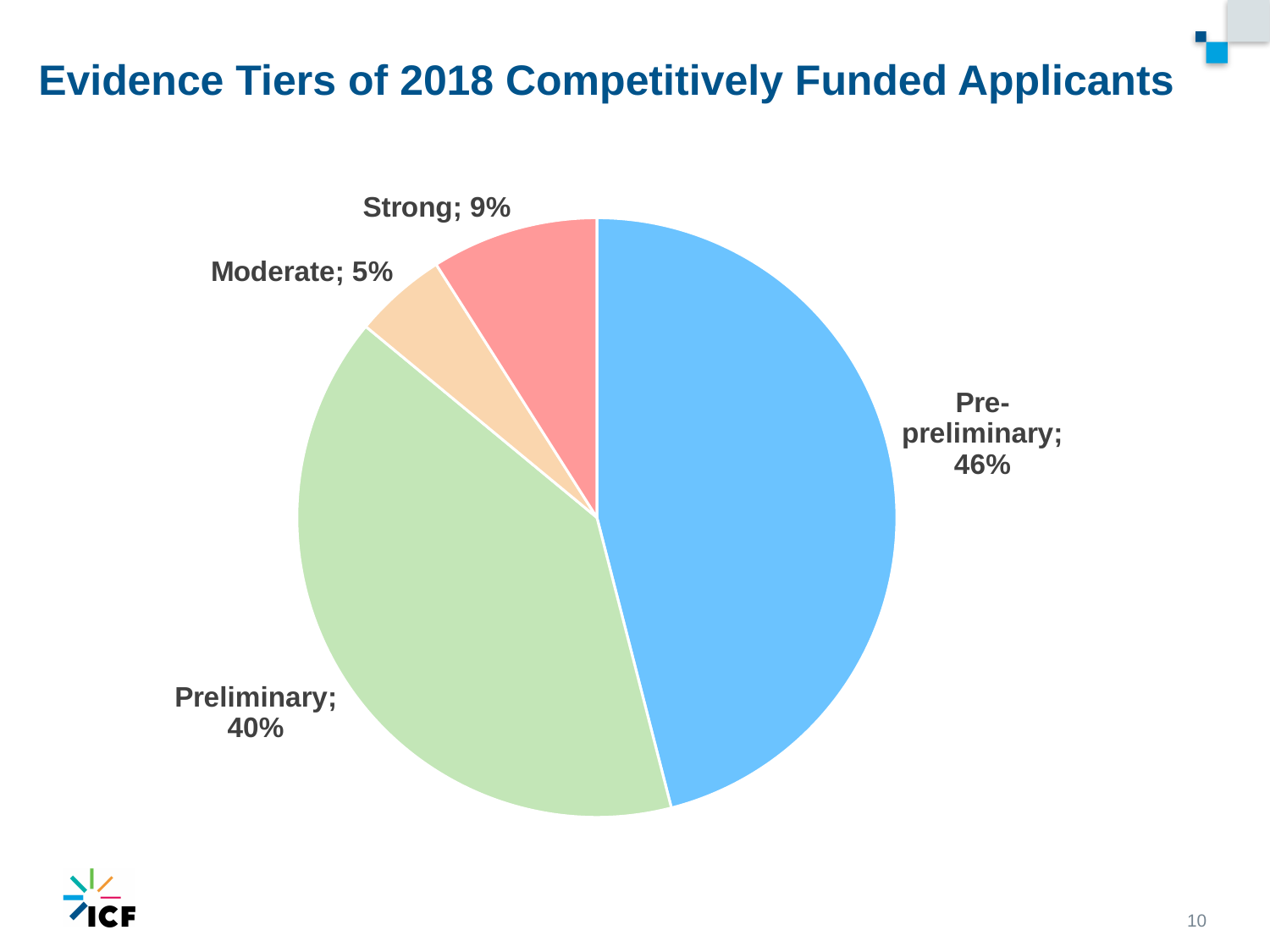
What is the difference in percentage points between the Strong and Moderate slices? 4 What is the difference in percentage points between the Pre-preliminary and Preliminary slices? 6 What is the value shown for the Moderate slice? 5% Which slice is larger, Strong or Moderate? Strong What is the value shown for the Preliminary slice? 40% Which evidence tier has the largest share of the pie? Pre-preliminary What is the value shown for the Strong slice? 9% What is the title of the chart on the slide? Evidence Tiers of 2018 Competitively Funded Applicants How many slices does the pie chart have? 4 Which evidence tier has the smallest share of the pie? Moderate What share of the pie does the Pre-preliminary slice represent? 46% What type of chart is shown on the slide? Pie chart